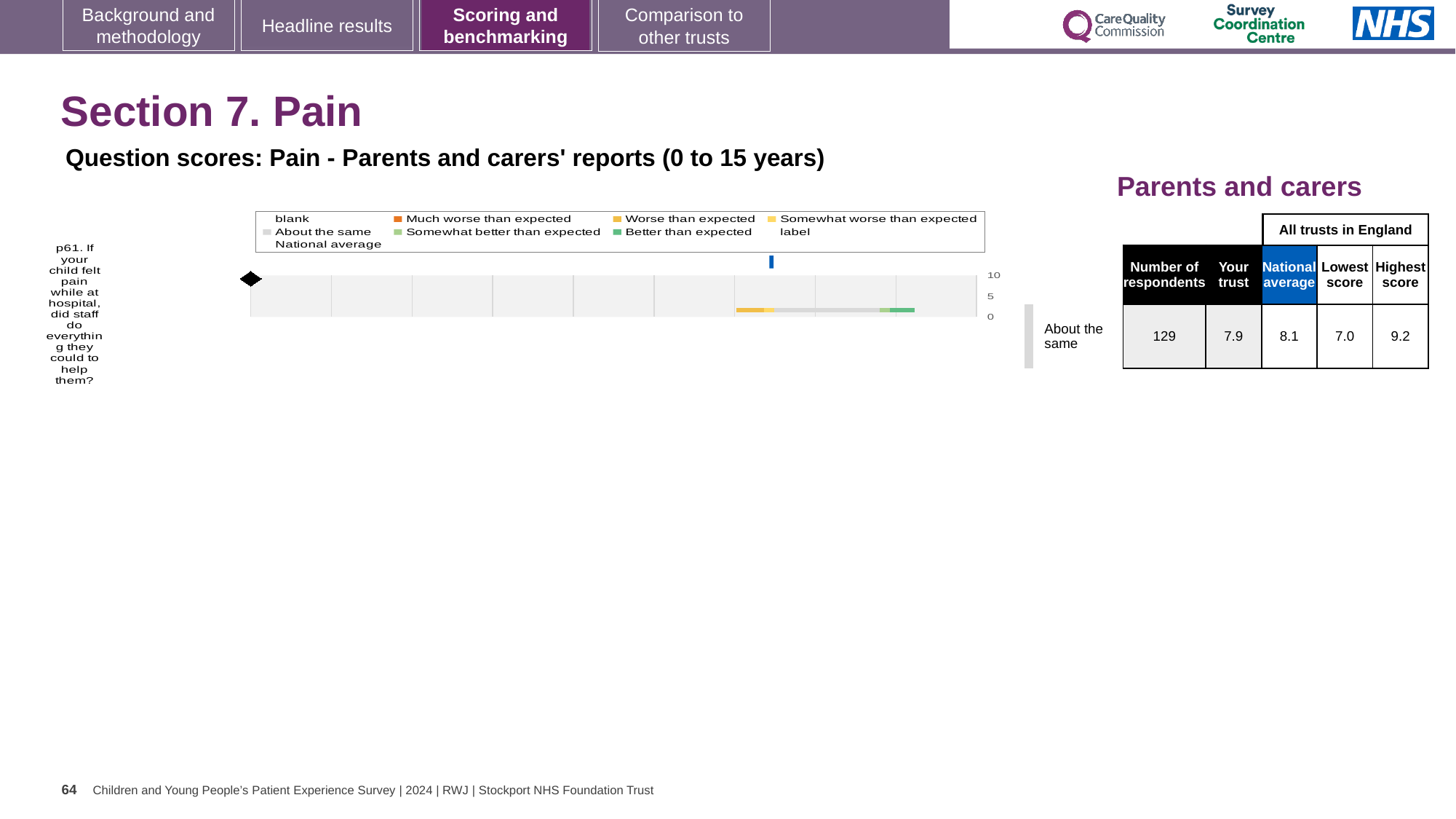
How many survey questions are plotted in the chart? 1 What is the highest value shown on the chart's axis? 10 How many respondents answered question p61? 129 According to the table, what is the score for Your trust on question p61? 7.9 Which legend entry is shown in orange? Much worse than expected According to the table, what is the Lowest score among all trusts in England for question p61? 7.0 According to the table, what is the Highest score among all trusts in England for question p61? 9.2 Is the national average marker for question p61 greater or less than 5? greater What is the difference between the Highest score and the Lowest score for question p61? 2.2 What kind of chart is shown on the slide? bar chart According to the table, what is the National average score for question p61? 8.1 How many entries does the chart legend list? 9